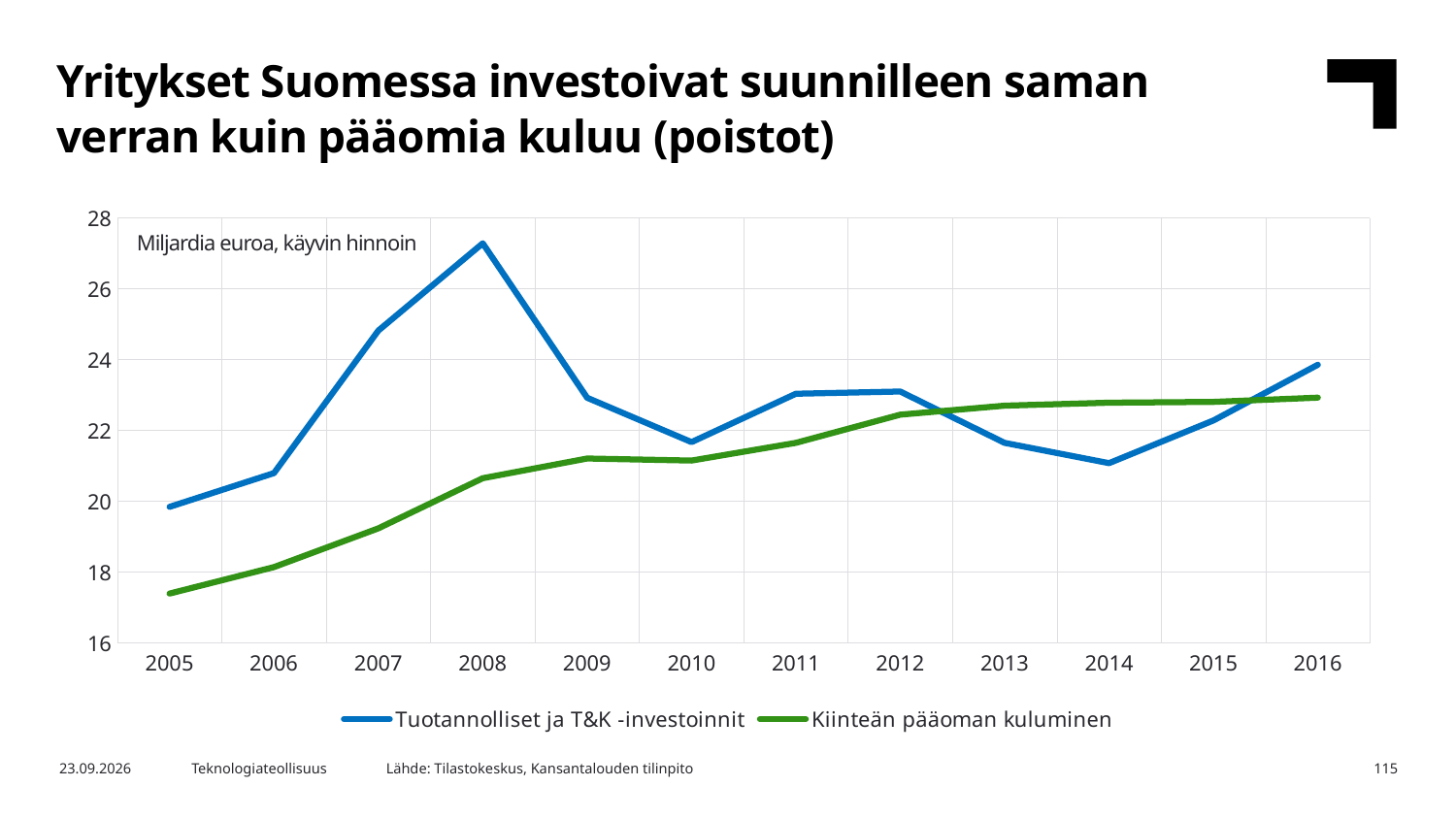
Does the Kiinteän pääoman kuluminen line generally rise or fall from 2005 to 2016? rise In 2014, which series has the higher value? Kiinteän pääoman kuluminen How many years are shown on the x axis? 12 Is the value for Tuotannolliset ja T&K -investoinnit in 2010 greater or less than 22? less In which year does the Tuotannolliset ja T&K -investoinnit line reach its highest value? 2008 Is the value for Kiinteän pääoman kuluminen in 2005 greater or less than 18? less In which year is the Tuotannolliset ja T&K -investoinnit line at its lowest? 2005 In which year is the Kiinteän pääoman kuluminen line at its lowest? 2005 How many series does the legend list? 2 Is the value for Tuotannolliset ja T&K -investoinnit in 2008 greater or less than 26? greater What unit is stated in the text box inside the chart area? Miljardia euroa, käyvin hinnoin What kind of chart is shown on the slide? line chart